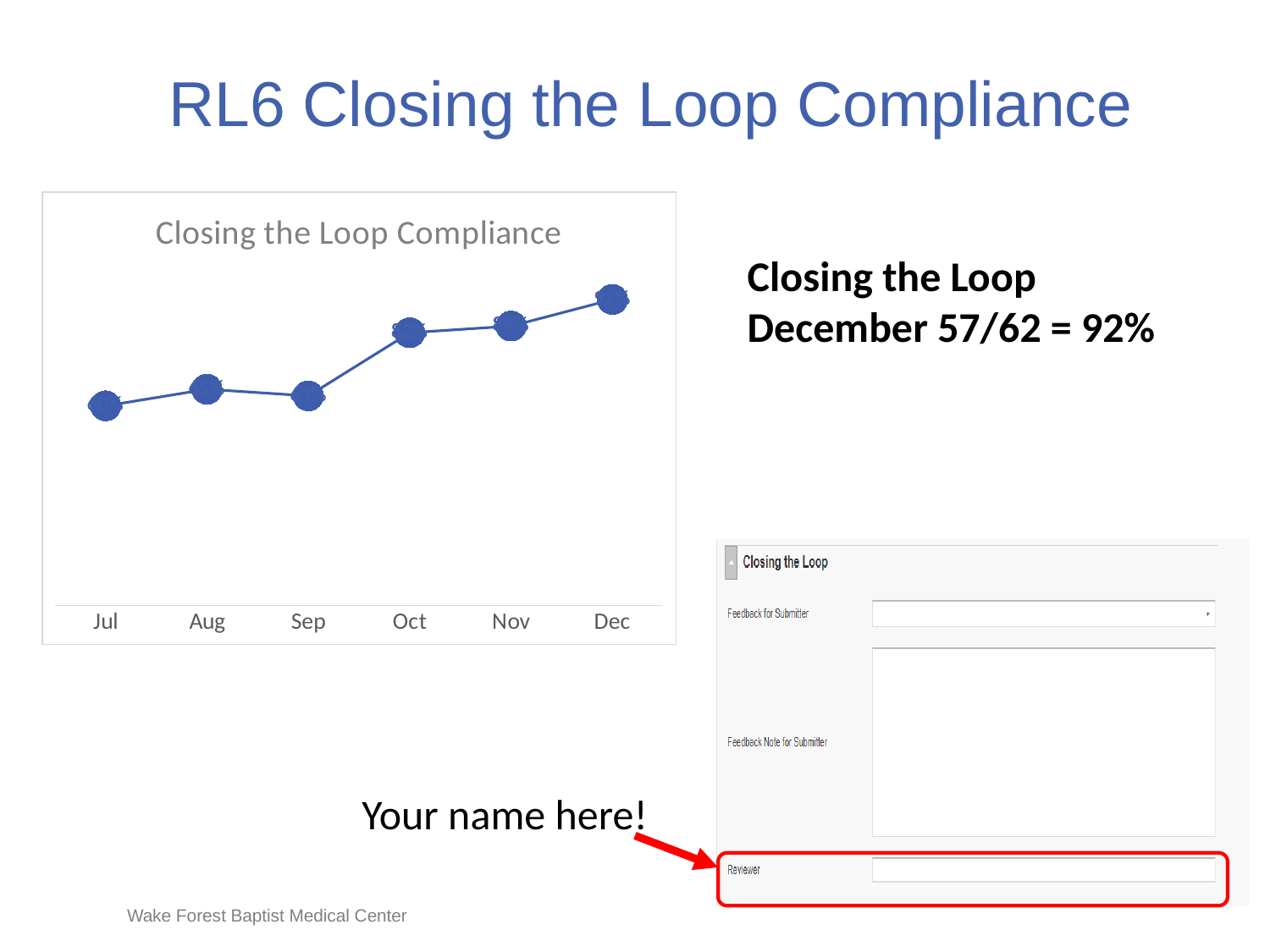
Is the value for Nov larger or smaller than the value for Aug? larger How many months are plotted on the x axis of the chart? 6 What kind of chart is shown on the slide? line chart What is the title of the chart? Closing the Loop Compliance Is the value for Jul larger or smaller than the value for Dec? smaller Which month has the highest value in the Closing the Loop Compliance chart? Dec What colour is the line in the chart? blue Which month is the first category on the x axis? Jul Do the values generally rise or fall from Jul to Dec? rise Is the value for Oct larger or smaller than the value for Sep? larger